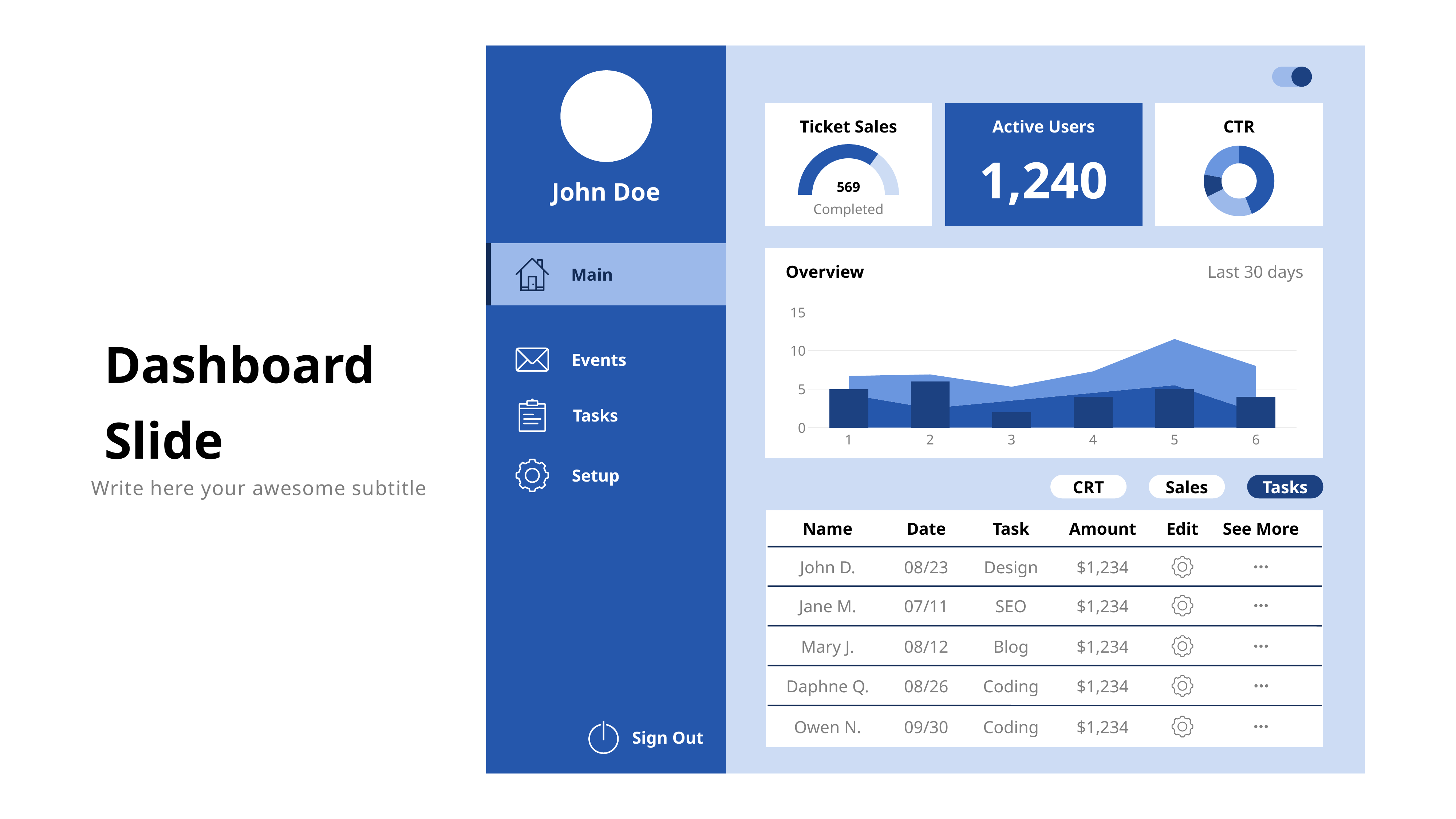
In the Overview chart, is the bar for category 2 taller or shorter than the bar for category 3? taller What kind of chart is shown in the CTR card? Donut chart In the Overview chart, which category has the lowest bar? 3 In the Overview chart, what is the highest value shown on the y axis? 15 What time period does the Overview chart cover, according to the label at its top right? Last 30 days In the Overview chart, which category has the tallest bar? 2 What value is shown in the centre of the Ticket Sales gauge? 569 In the Overview chart, is the bar for category 3 greater or less than 5? less In the Overview chart, how many categories are shown on the x axis? 6 In the Overview chart, do the bars rise or fall from category 2 to category 3? fall In the Overview chart, is the bar for category 2 greater or less than 5? greater In the Overview chart, is the peak of the light blue area at category 5 greater or less than 10? greater